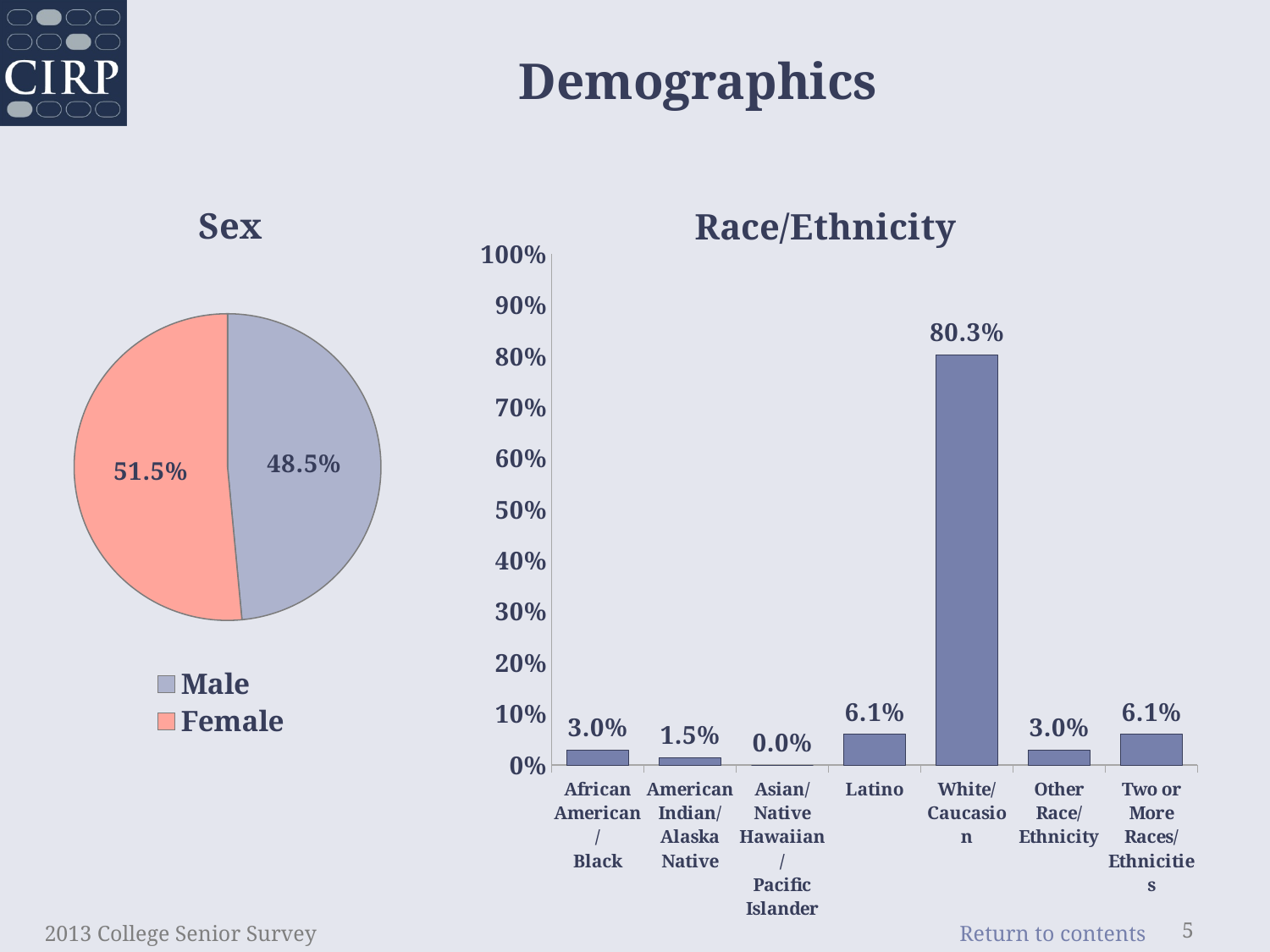
In the Race/Ethnicity chart, how many categories are shown? 7 What kind of chart is the Race/Ethnicity chart? Bar chart In the Race/Ethnicity chart, what is the value for Latino? 6.1% In the Race/Ethnicity chart, what is the difference between White/Caucasian and Latino? 74.2% In the Sex pie chart, which slice is larger, Male or Female? Female In the Race/Ethnicity chart, which category has the lowest value? Asian/Native Hawaiian/Pacific Islander In the Sex pie chart, what percentage is Male? 48.5% In the Race/Ethnicity chart, which category has the highest value? White/Caucasian In the Race/Ethnicity chart, what is the value for American Indian/Alaska Native? 1.5% In the Race/Ethnicity chart, what is the value for White/Caucasian? 80.3% In the Sex pie chart, what percentage is Female? 51.5% In the Sex pie chart, what is the difference between the Female and Male percentages? 3.0%